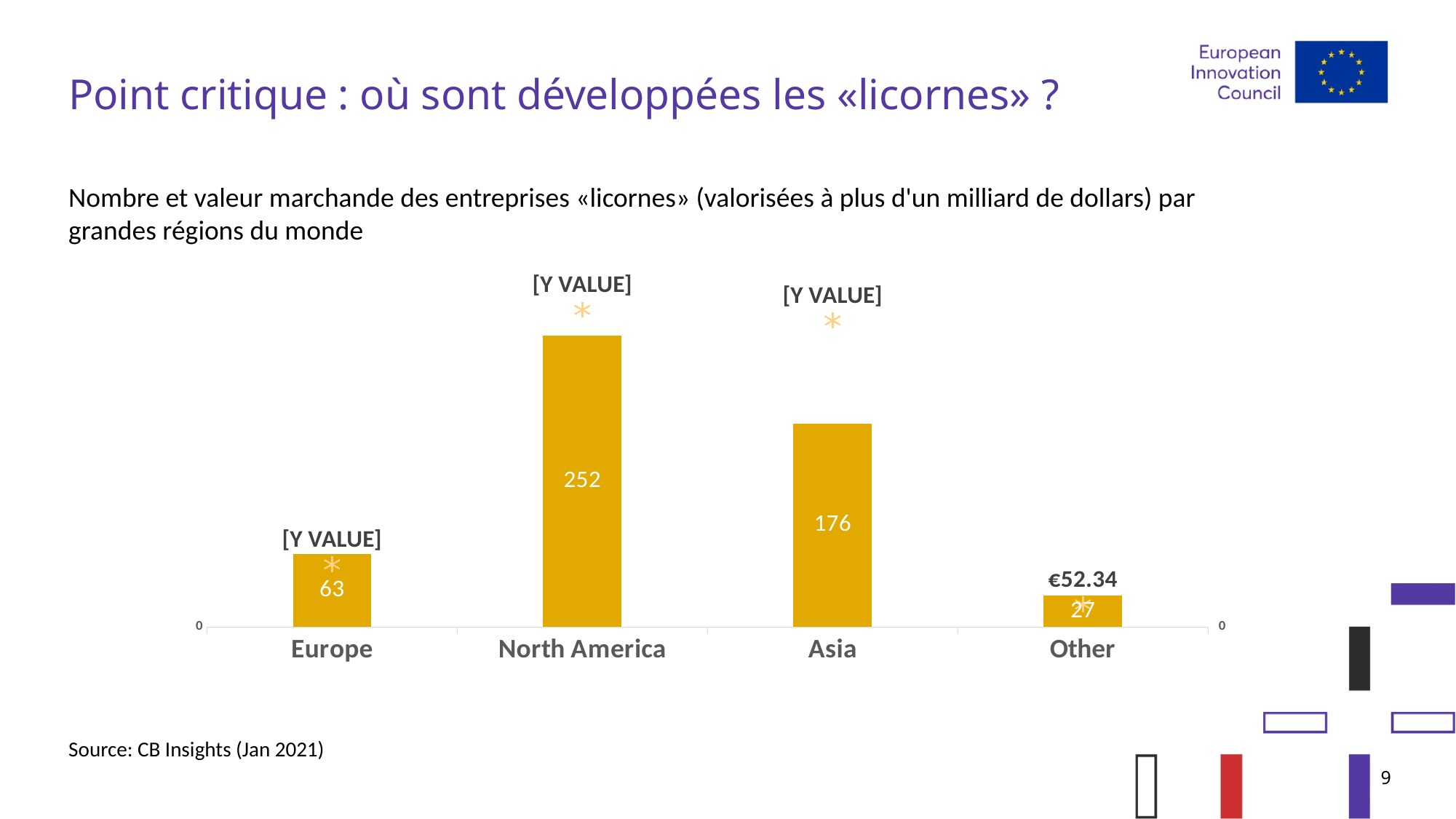
Which region has the lowest number of unicorn companies? Other Which region has the highest number of unicorn companies? North America What is the difference between the number of unicorns in Europe and in Other? 36 What is the number of unicorn companies shown for North America? 252 What is the number of unicorn companies shown for Other? 27 How many regions are shown on the x axis of the chart? 4 What kind of chart is used to show the number of unicorn companies by region? Bar chart Which has more unicorn companies, Europe or Asia? Asia What is the difference between the number of unicorns in North America and in Asia? 76 What market value label is printed above the Other bar? €52.34 What is the number of unicorn companies shown for Europe? 63 What is the number of unicorn companies shown for Asia? 176